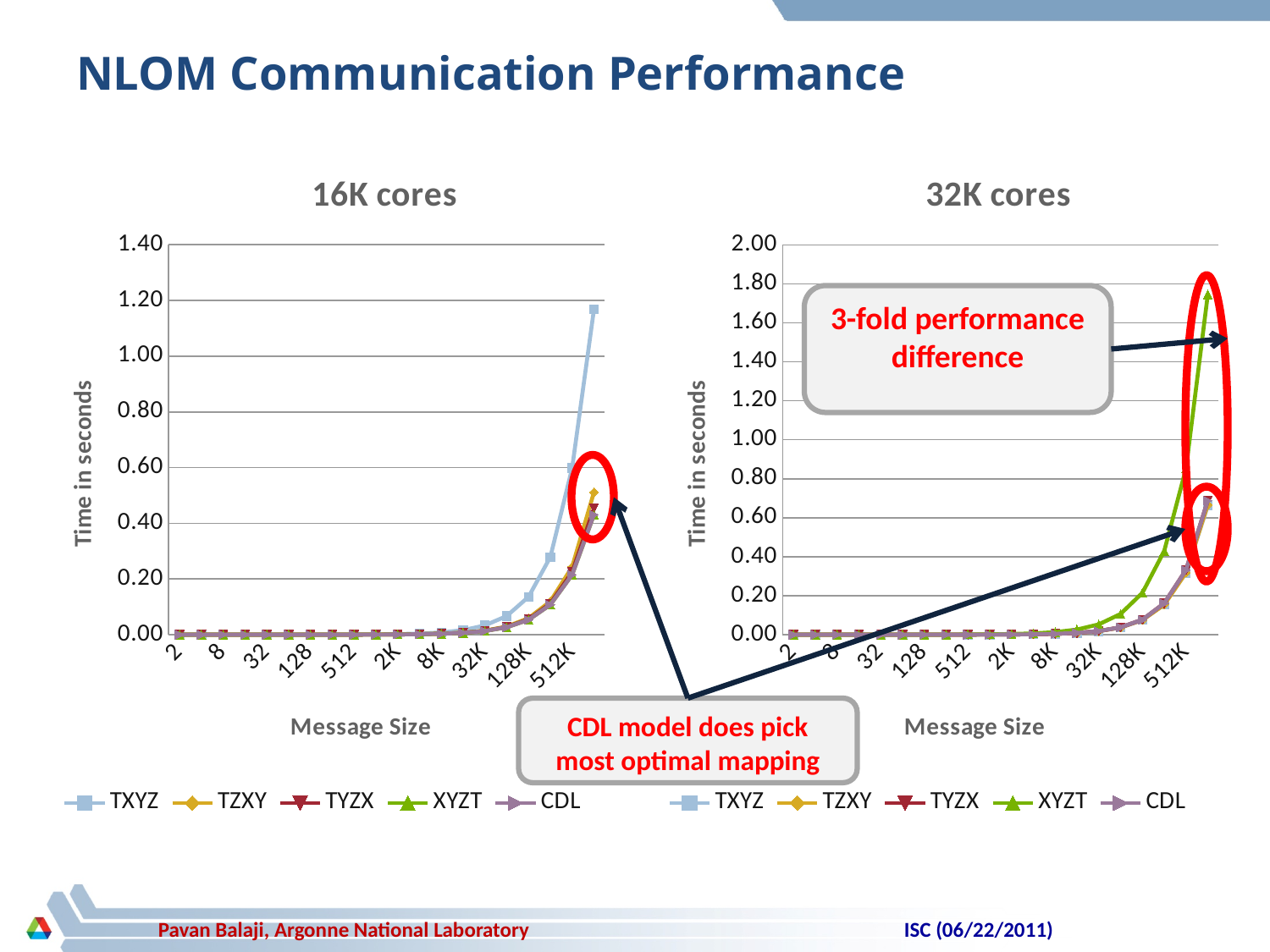
In the "32K cores" chart, is the highest value of XYZT greater or less than 1.40? greater What is the y-axis title of the "32K cores" chart? Time in seconds In the "32K cores" chart, is the highest value of CDL greater or less than 1.00? less How many series does the legend of the "32K cores" chart list? 5 What is the x-axis title of the "16K cores" chart? Message Size What kind of chart is the "16K cores" chart? line chart In the "16K cores" chart, do the times rise or fall as message size increases along the x axis? rise In the "32K cores" chart, at the largest message size, which is larger: XYZT or TZXY? XYZT In the "16K cores" chart, which series reaches the highest time at the largest message size? TXYZ In the "16K cores" chart, is the highest value of TXYZ greater or less than 1.00? greater In the "16K cores" chart, at the largest message size, which is larger: TXYZ or CDL? TXYZ In the "32K cores" chart, which series reaches the highest time at the largest message size? XYZT